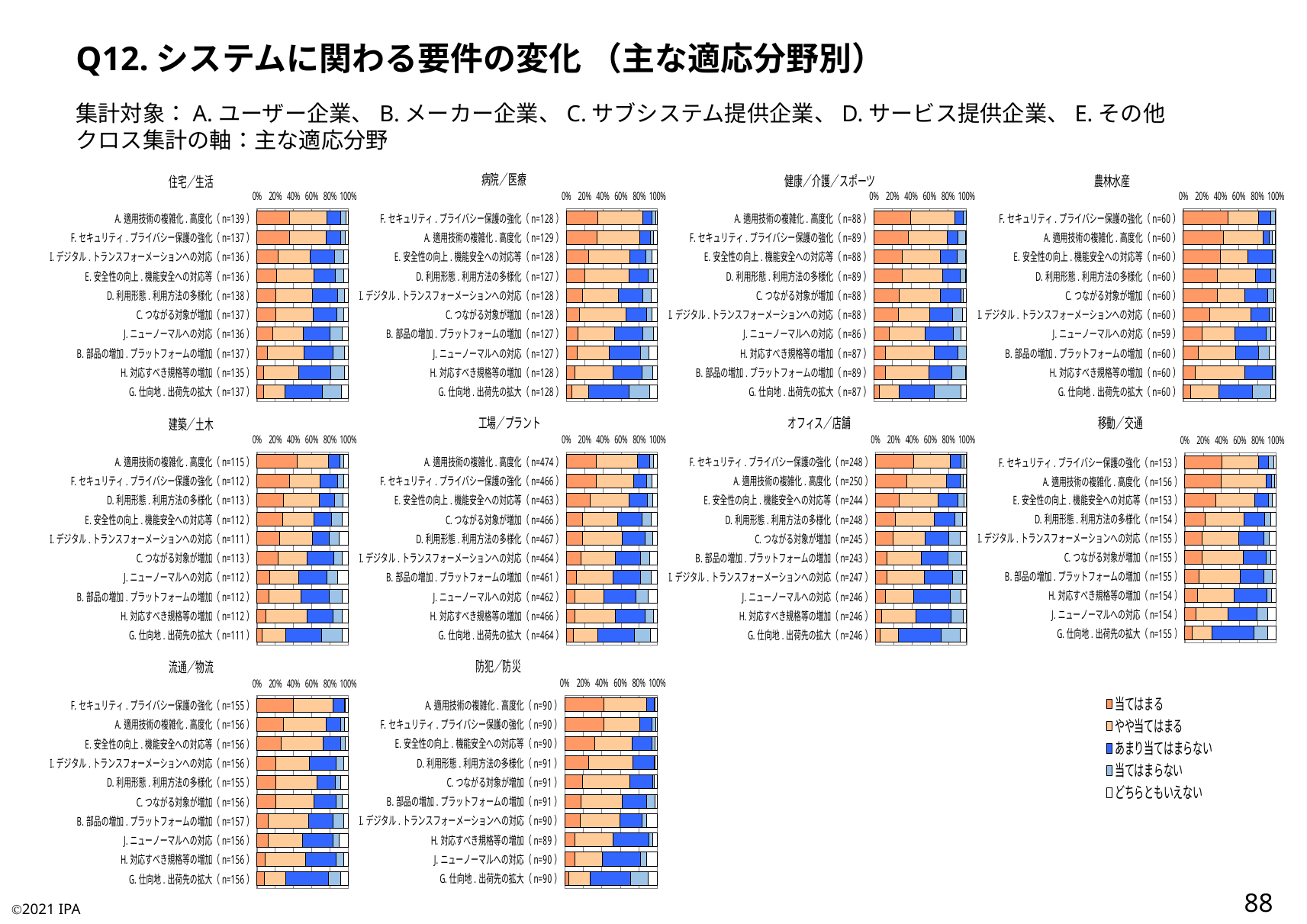
What is the title of the top-left chart? 住宅／生活 In the 防犯／防災 chart, is the 当てはまる share for A. 適用技術の複雑化.高度化 greater or less than 20%? greater In the 住宅／生活 chart, is the 当てはまる share for G. 仕向地.出荷先の拡大 greater or less than 20%? less In the 工場／プラント chart, what is the sample size (n) shown for A. 適用技術の複雑化.高度化? 474 What is the first entry in the legend? 当てはまる How many separate charts are shown on the slide? 10 How many series does the legend list for these charts? 5 How many categories are plotted in the 病院／医療 chart? 10 How many categories are plotted in the 流通／物流 chart? 10 In the 農林水産 chart, is the 当てはまる share for G. 仕向地.出荷先の拡大 greater or less than 40%? less In the オフィス／店舗 chart, what is the sample size (n) shown for A. 適用技術の複雑化.高度化? 250 What kind of chart is used for the 住宅／生活 panel? stacked bar chart